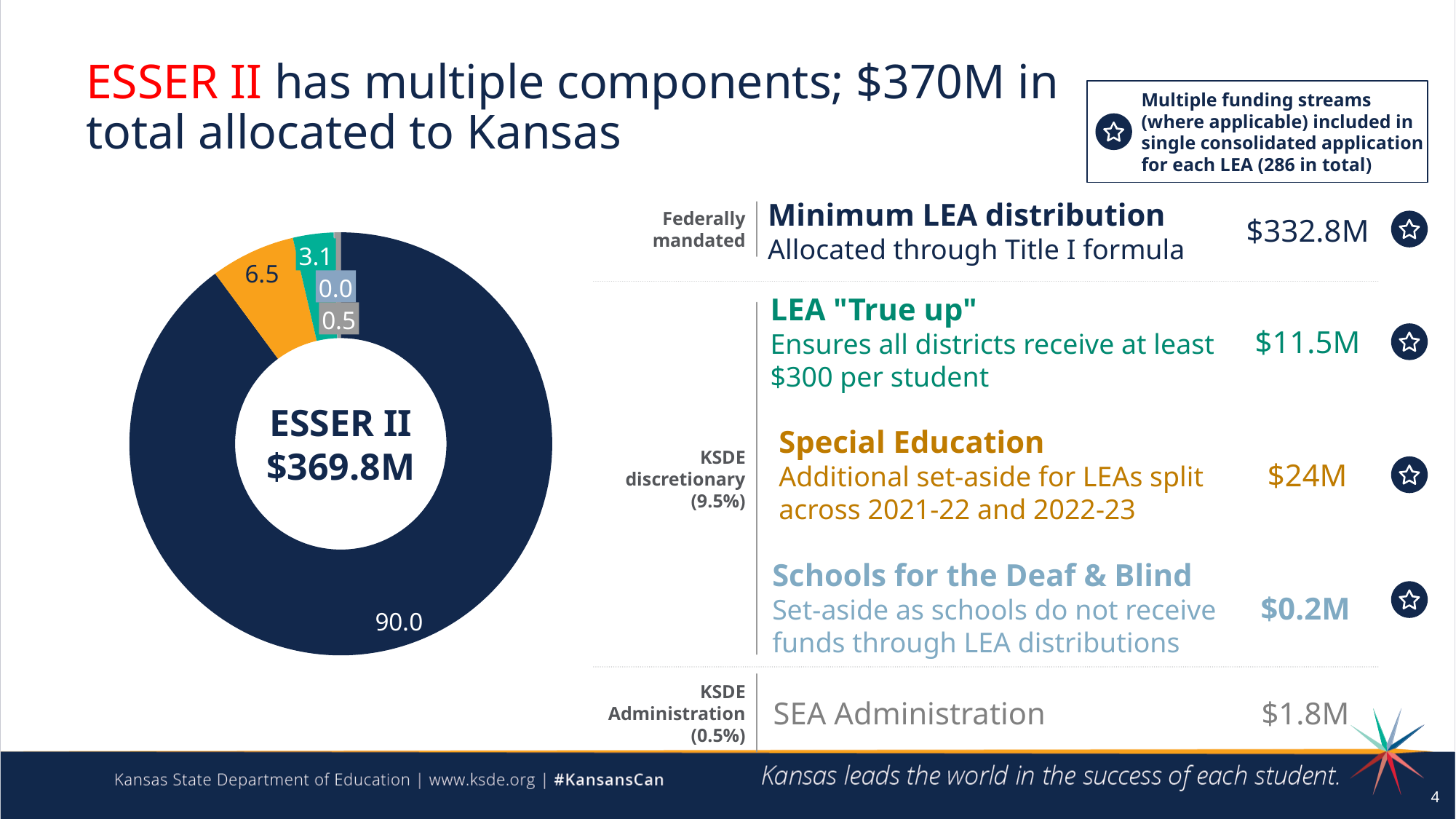
How many slices are labelled on the donut chart? 5 What value is printed on the teal slice of the donut chart? 3.1 Is the value printed on the dark navy slice of the donut chart greater or less than 50? greater What label is shown in the centre of the donut chart above the total amount? ESSER II What value is printed on the orange slice of the donut chart? 6.5 What total amount is shown in the centre of the donut chart? $369.8M What kind of chart is shown on the left of the slide? Donut (pie) chart What value is printed on the light blue slice of the donut chart? 0.0 What value is printed on the largest slice of the donut chart? 90.0 What is the difference between the values printed on the orange slice and the teal slice of the donut chart? 3.4 Which slice of the donut chart has the larger printed value, the orange slice or the teal slice? The orange slice What value is printed on the gray slice of the donut chart? 0.5